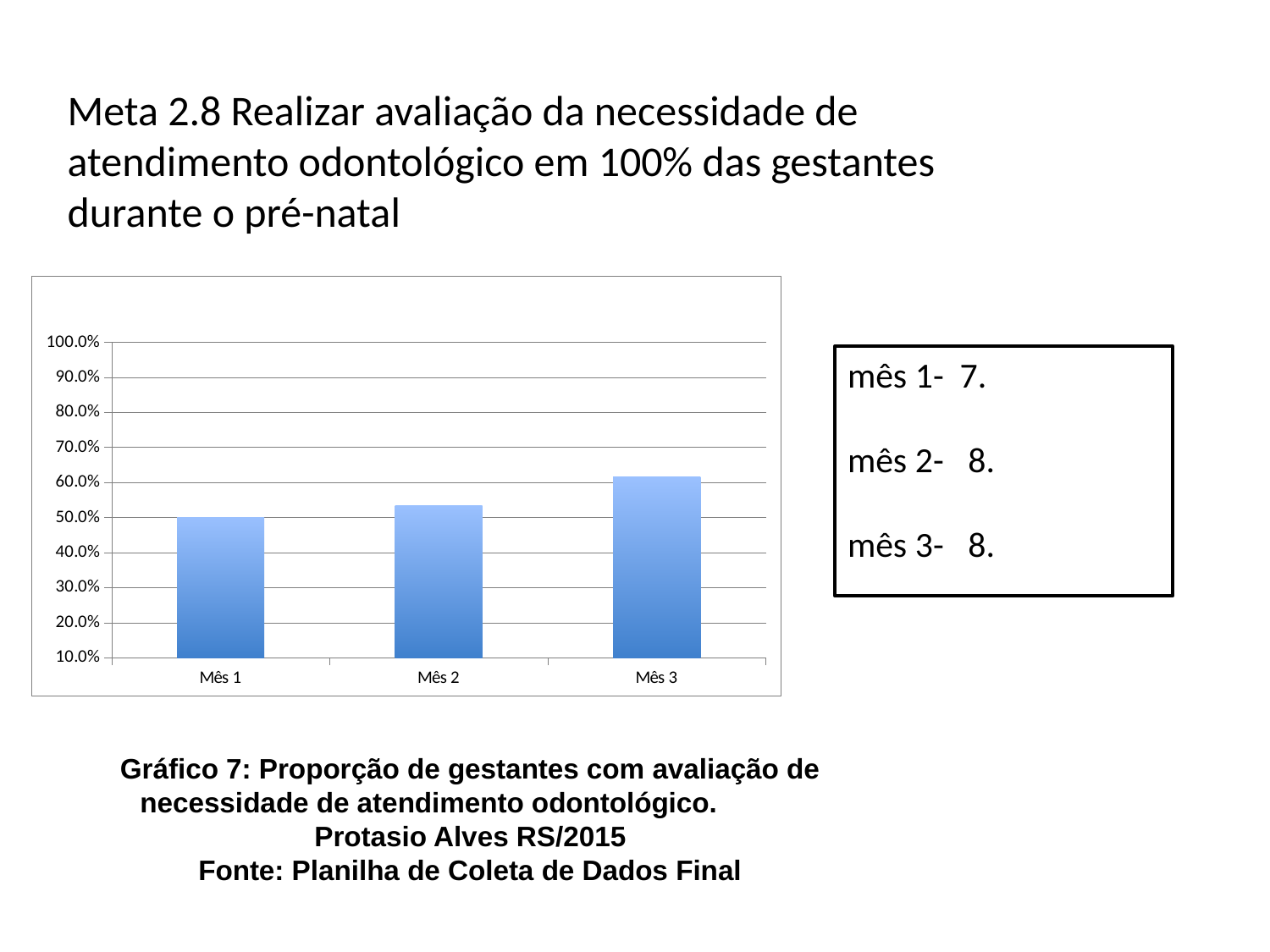
Which is larger, the value for Mês 2 or the value for Mês 3? Mês 3 Which month has the highest value in the chart? Mês 3 Is the value for Mês 2 greater or less than 60.0%? less Which month has the lowest value in the chart? Mês 1 Is the value for Mês 3 greater or less than 70.0%? less What type of chart is shown on the slide? bar chart What is the value for Mês 1 in the chart? 50.0% Do the values rise or fall from Mês 1 to Mês 3? rise How many months (categories) are plotted in the chart? 3 What is the number of the graph given in the caption below the chart? Gráfico 7 Is the value for Mês 3 greater or less than 50.0%? greater What is the highest value shown on the vertical axis of the chart? 100.0%